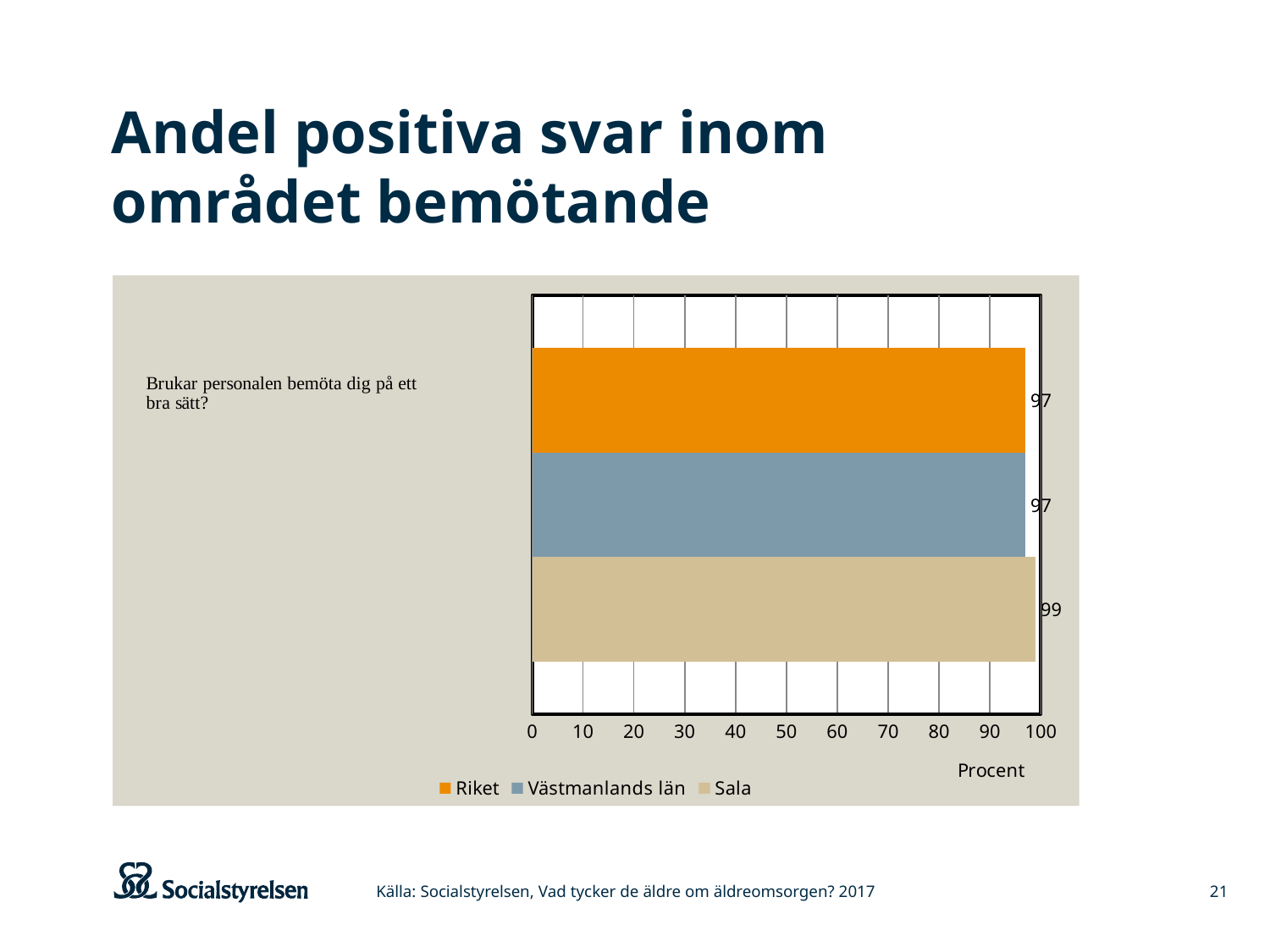
What is the label on the horizontal axis? Procent Do the values for Riket and Västmanlands län differ? No What is the value for Västmanlands län? 97 How many series does the legend list? 3 Which series has the highest value? Sala What is the maximum value shown on the horizontal axis? 100 What is the difference between the values for Sala and Riket? 2 What kind of chart is shown on the slide? bar chart Is the value for Riket greater or less than 90? greater What is the value for Riket? 97 What is the value for Sala? 99 Which is larger, the value for Sala or the value for Västmanlands län? Sala